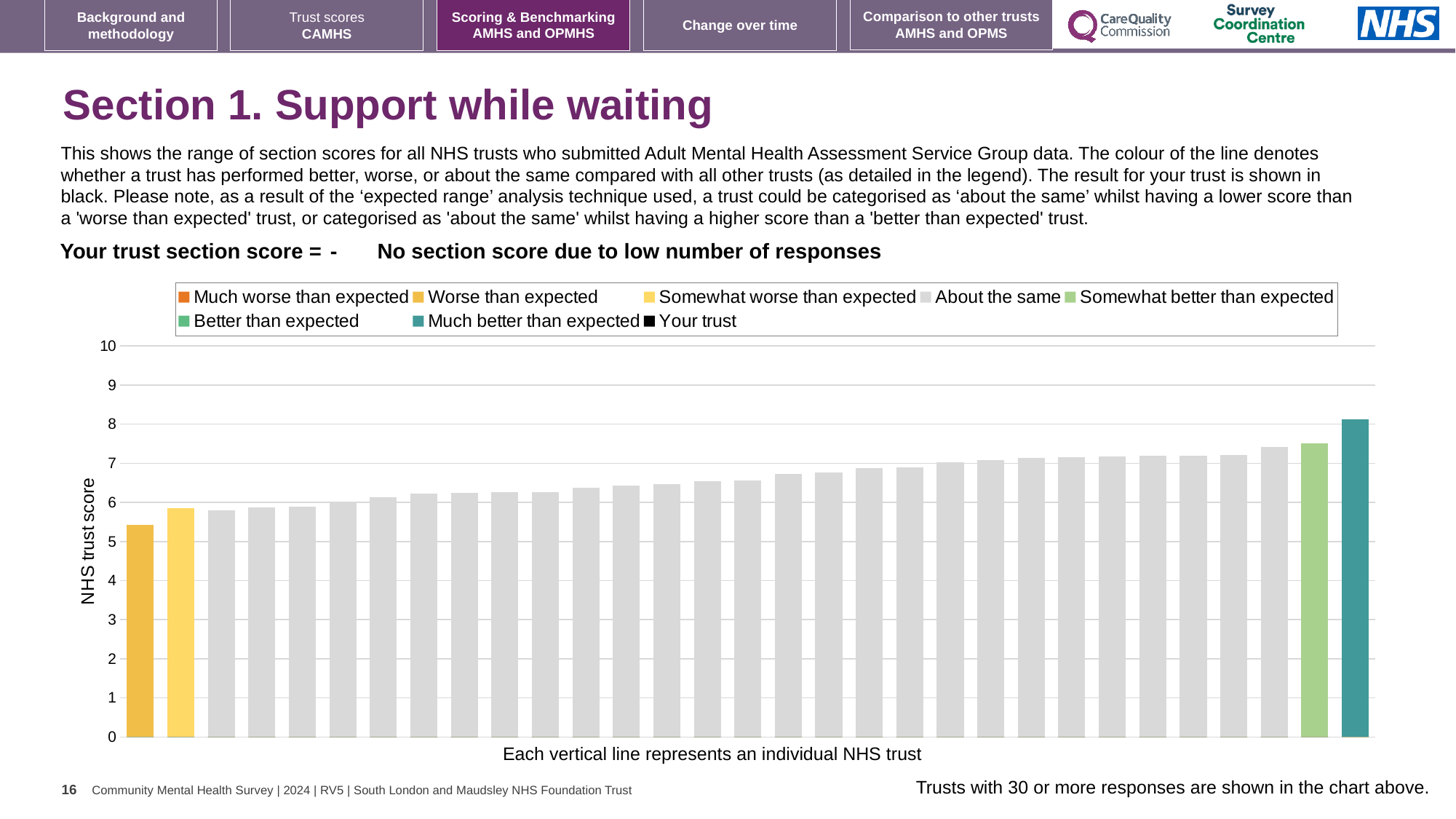
What is the highest value shown on the y axis of the chart? 10 How many entries does the chart legend list? 8 Is the value of the second bar from the right greater or less than 7? greater Is the value of the leftmost bar greater or less than 6? less How many bars (NHS trusts) are plotted in the chart? 31 What kind of chart is shown on the slide? bar chart Do the bar values rise or fall from left to right along the x axis? rise Is the value of the rightmost bar greater or less than 7? greater Which bar is the highest: the leftmost bar or the rightmost bar? the rightmost bar What is the title of the y axis of the chart? NHS trust score